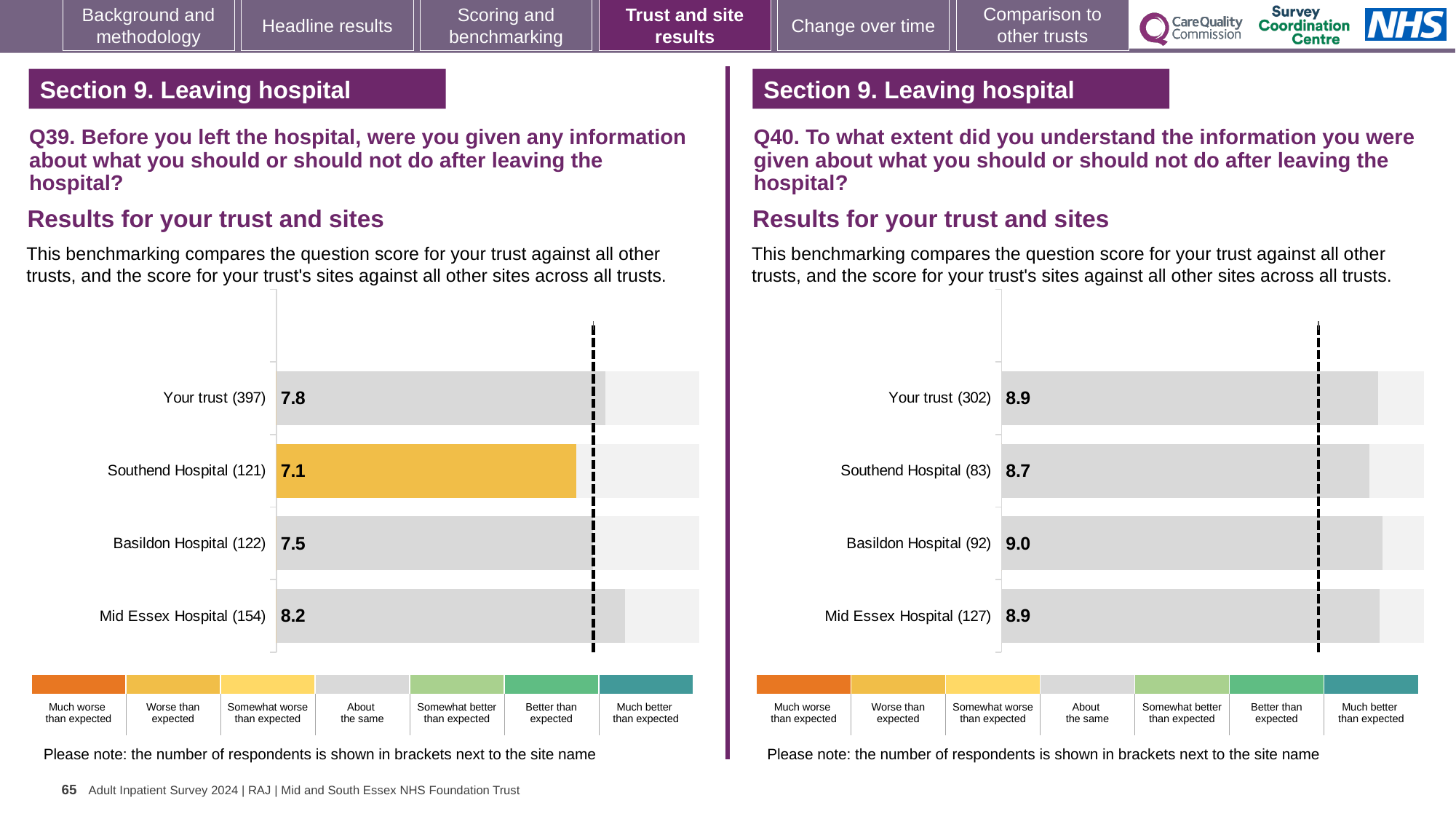
On the Q40 chart (right), what is the difference between the scores for Basildon Hospital and Southend Hospital? 0.3 On the Q39 chart (left), what is the difference between the scores for Mid Essex Hospital and Basildon Hospital? 0.7 On the Q39 chart (left), which site has the highest score? Mid Essex Hospital On the Q40 chart (right), which site has the lowest score? Southend Hospital On the Q40 chart (right), what is the score for Mid Essex Hospital? 8.9 On the Q39 chart (left), what is the score for Southend Hospital? 7.1 On the Q39 chart (left), how many bars are plotted? 4 On the Q39 chart (left), what is the score for Your trust? 7.8 What kind of chart is used on the Q40 chart (right)? Bar chart On the Q39 chart (left), which site has the lowest score? Southend Hospital On the Q39 chart (left), which bar is coloured differently from the others? Southend Hospital On the Q40 chart (right), what is the score for Basildon Hospital? 9.0